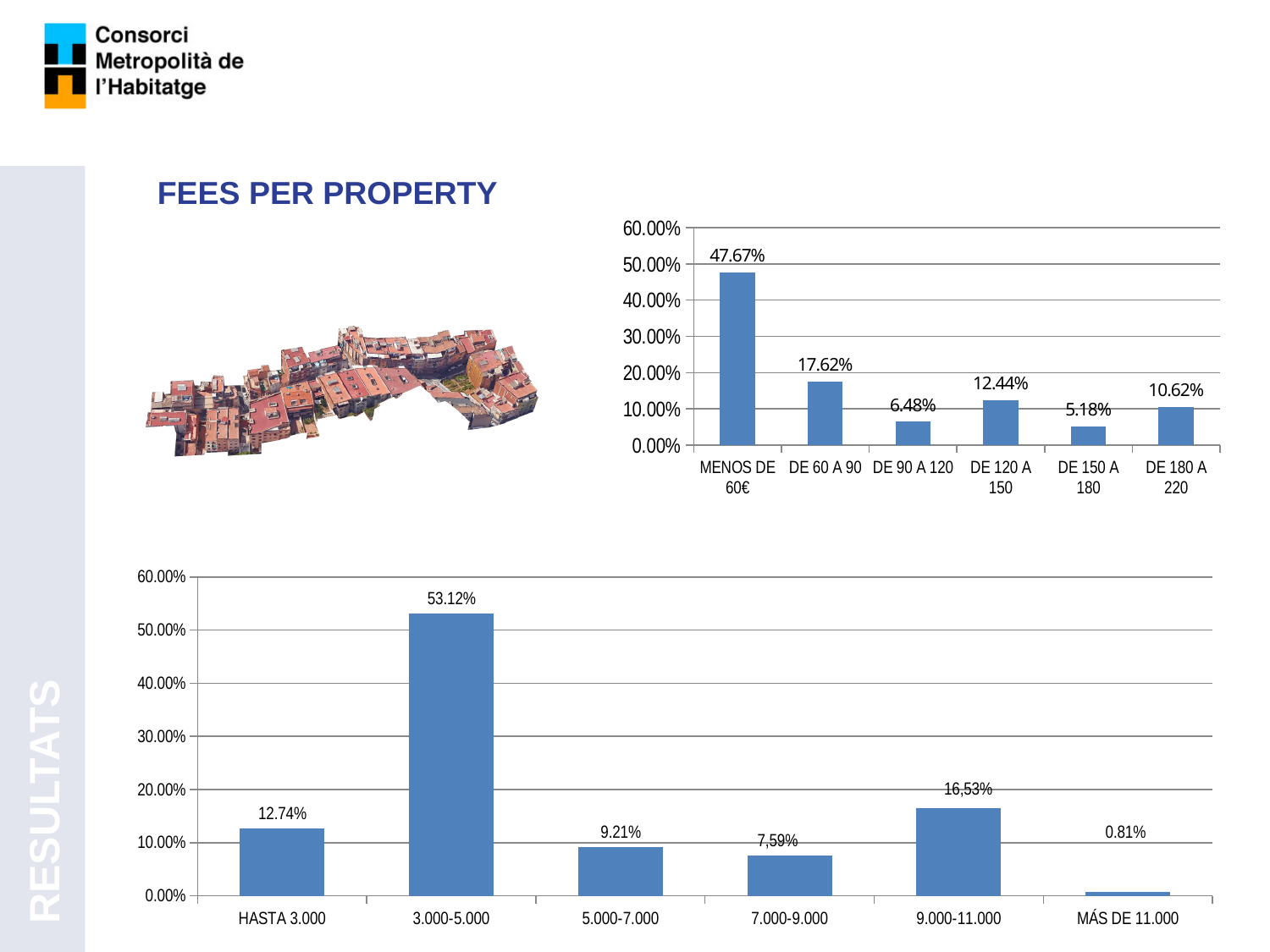
In the bottom chart, what is the value for 3.000-5.000? 53.12% In the top-right chart, what is the difference between the values for DE 60 A 90 and DE 90 A 120? 11.14% In the bottom chart, is the value for 7.000-9.000 greater or less than 10.00%? less In the top-right chart, what is the value for DE 150 A 180? 5.18% What kind of chart is the bottom chart? bar chart In the bottom chart, which category has the highest value? 3.000-5.000 In the top-right chart, which category has the lowest value? DE 150 A 180 How many categories are shown in the top-right chart? 6 In the top-right chart, what is the value for MENOS DE 60€? 47.67% In the bottom chart, what is the value for MÁS DE 11.000? 0.81% In the top-right chart, which is larger: DE 120 A 150 or DE 180 A 220? DE 120 A 150 In the bottom chart, what is the difference between the values for 9.000-11.000 and HASTA 3.000? 3.79%